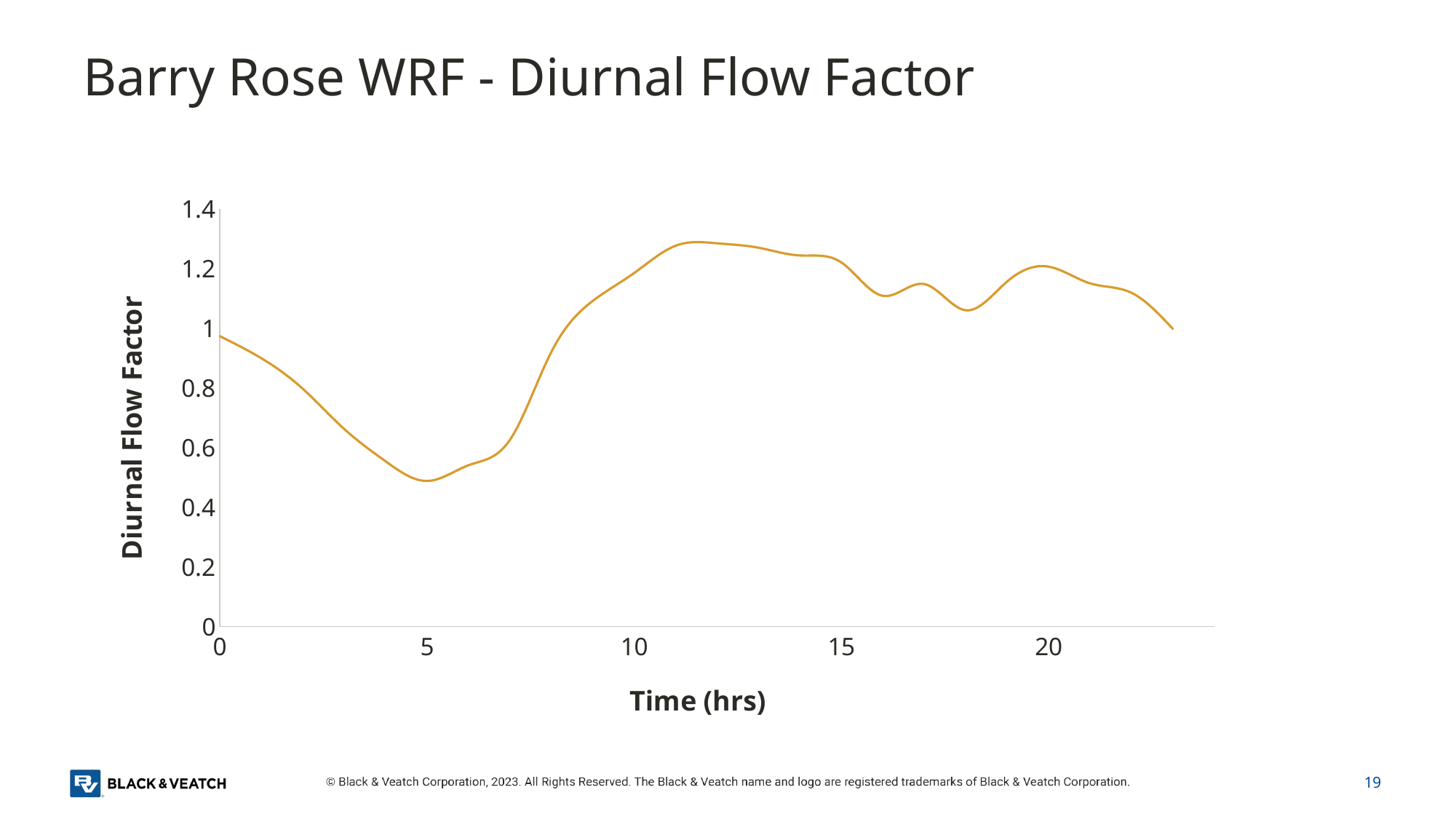
Is the Diurnal Flow Factor at 10 hrs greater or less than 1? greater Does the Diurnal Flow Factor rise or fall between 5 and 10 hrs? rise What is the label of the y axis? Diurnal Flow Factor Which is larger, the Diurnal Flow Factor at 5 hrs or at 15 hrs? 15 hrs Is the Diurnal Flow Factor at 2 hrs greater or less than 1? less How many lines are plotted on the chart? 1 Is the Diurnal Flow Factor at 15 hrs greater or less than 1? greater Does the Diurnal Flow Factor rise or fall between 0 and 5 hrs? fall What is the title of the slide's chart? Barry Rose WRF - Diurnal Flow Factor What kind of chart is shown on the slide? line chart